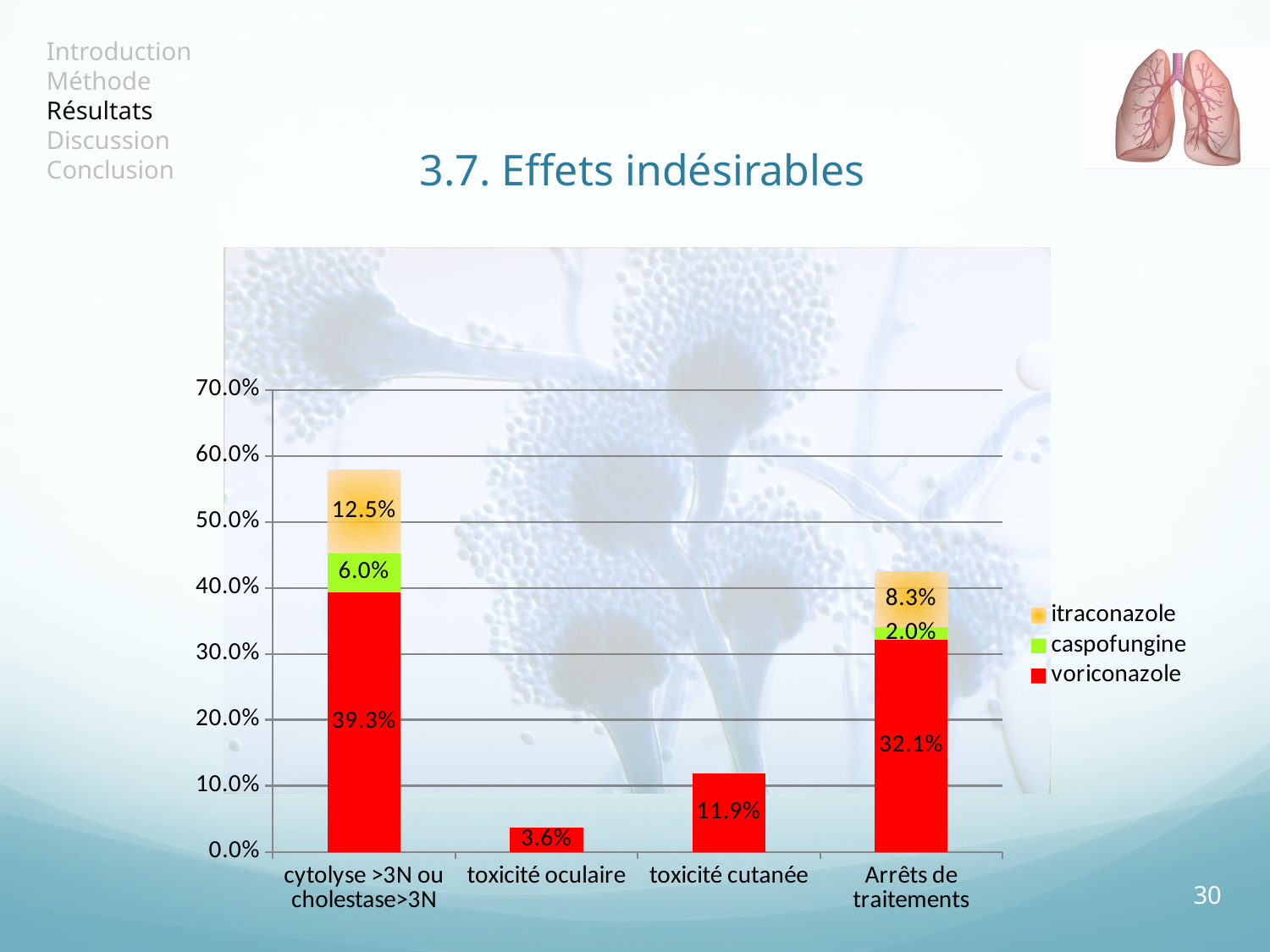
How many categories are shown on the x axis? 4 How many series does the legend list? 3 What kind of chart is shown on the slide? stacked bar chart What is the itraconazole value for 'Arrêts de traitements'? 8.3% Which category has the lowest voriconazole value? toxicité oculaire What is the voriconazole value for the 'cytolyse >3N ou cholestase>3N' category? 39.3% Which is larger: the voriconazole value for 'toxicité cutanée' or for 'toxicité oculaire'? toxicité cutanée What is the difference between the voriconazole values for 'cytolyse >3N ou cholestase>3N' and 'Arrêts de traitements'? 7.2% What is the total of the stacked bar for 'Arrêts de traitements'? 42.4% What is the caspofungine value for 'cytolyse >3N ou cholestase>3N'? 6.0% What is the voriconazole value for 'toxicité oculaire'? 3.6% Which category has the highest voriconazole value? cytolyse >3N ou cholestase>3N